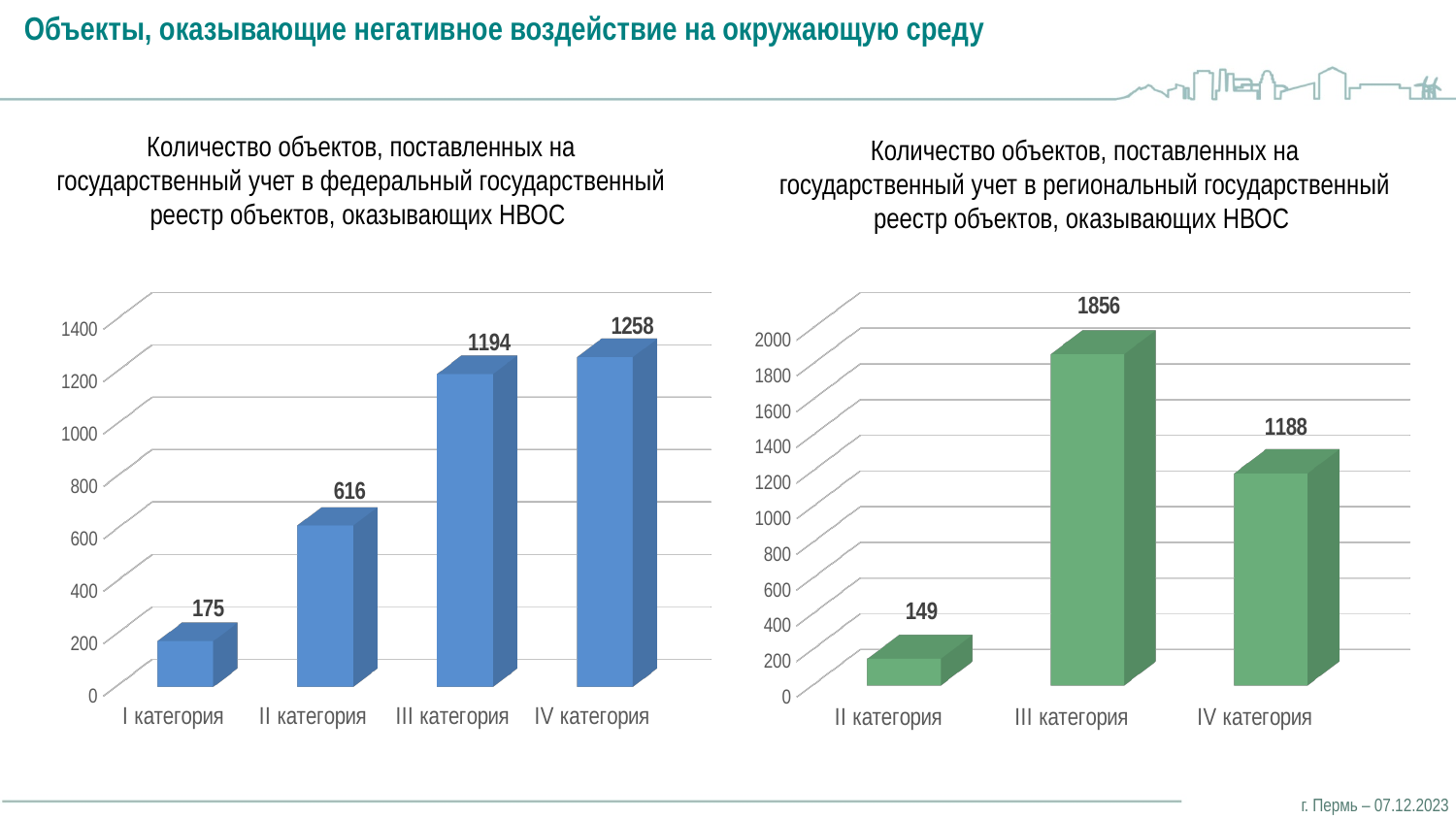
How many categories are shown in the right chart (regional register)? 3 In the left chart (federal register), which is larger: II категория or I категория? II категория In the left chart (federal register), which category has the highest value? IV категория In the right chart (regional register), which category has the lowest value? II категория In the right chart (regional register), what is the value for II категория? 149 What type of chart is the right chart (regional register)? Bar chart In the left chart (federal register), what is the value for III категория? 1194 How many categories are shown in the left chart (federal register)? 4 In the right chart (regional register), what is the difference between III категория and IV категория? 668 In the left chart (federal register), do the values rise or fall from I категория to IV категория? Rise In the left chart (federal register), what is the difference between IV категория and III категория? 64 In the right chart (regional register), is the value for IV категория greater or less than 1000? greater